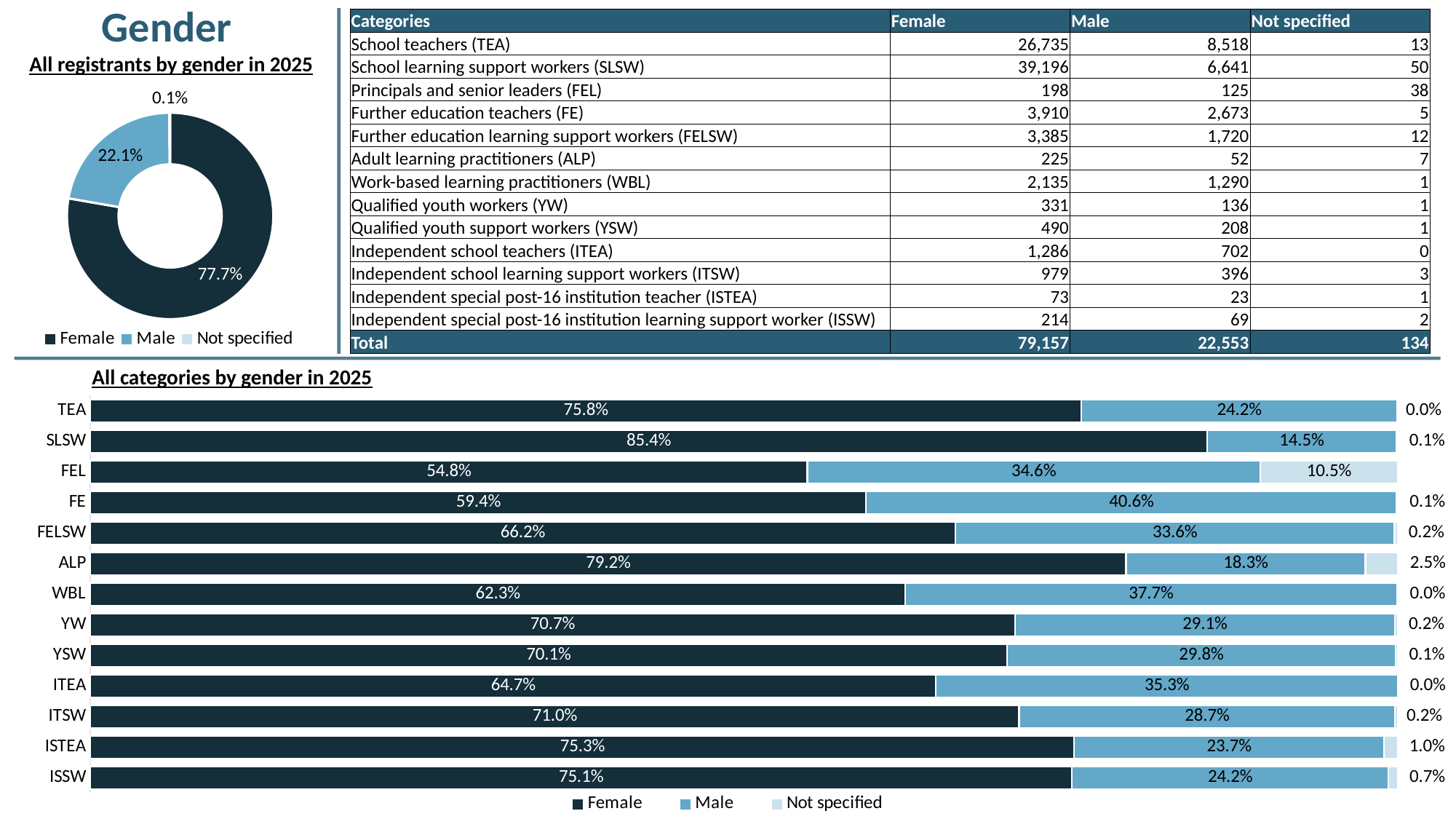
In the 'All categories by gender in 2025' chart, which category has the highest Female percentage? SLSW In the 'All categories by gender in 2025' chart, what is the Male percentage for FE? 40.6% What kind of chart is 'All registrants by gender in 2025'? Doughnut chart In the 'All registrants by gender in 2025' chart, what share of registrants are Male? 22.1% How many series does the legend of the 'All categories by gender in 2025' chart list? 3 How many categories are shown in the 'All categories by gender in 2025' chart? 13 In the 'All categories by gender in 2025' chart, what is the Female percentage for SLSW? 85.4% In the 'All categories by gender in 2025' chart, which category has the lowest Female percentage? FEL In the 'All categories by gender in 2025' chart, which has the larger Male percentage, FELSW or ITEA? ITEA In the 'All registrants by gender in 2025' chart, what share of registrants are Female? 77.7% In the 'All categories by gender in 2025' chart, which category has the highest Not specified percentage? FEL In the 'All categories by gender in 2025' chart, how much larger is the Female percentage than the Male percentage for WBL? 24.6 percentage points